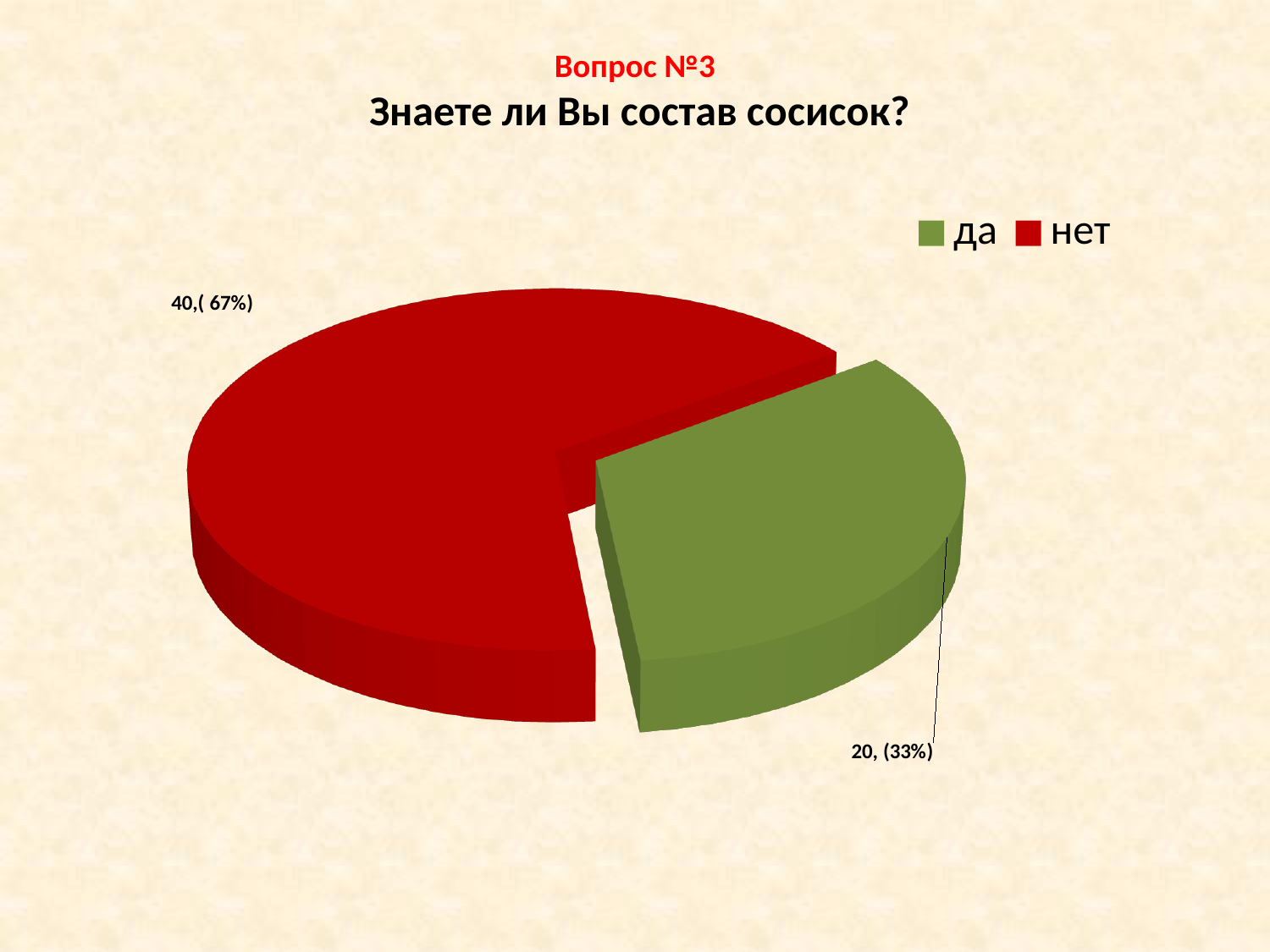
How many slices does the pie chart have? 2 Which slice is the largest? нет How many entries does the legend list? 2 Which is larger, the "да" slice or the "нет" slice? нет What kind of chart is shown on the slide? pie chart Which slice is the smallest? да What is the difference between the counts for "нет" and "да"? 20 What percentage share does the "да" slice have? 33% What is the count shown for the "да" slice? 20 What percentage share does the "нет" slice have? 67% What is the count shown for the "нет" slice? 40 What colour is the "да" slice? green